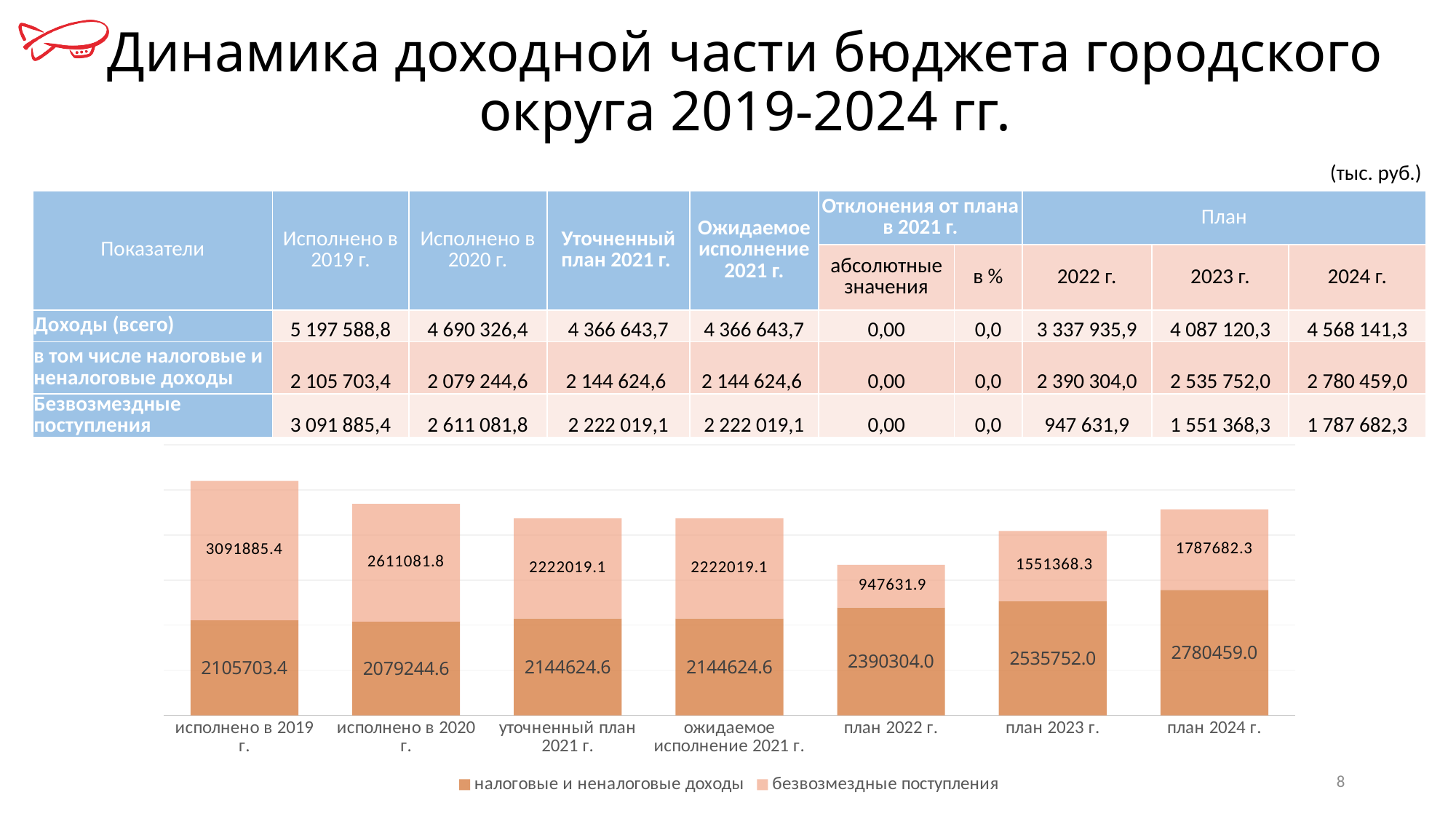
What is the value of безвозмездные поступления for исполнено в 2020 г.? 2611081.8 Which category has the lowest value of безвозмездные поступления? план 2022 г. Which category has the highest value of безвозмездные поступления? исполнено в 2019 г. Which category has the highest value of налоговые и неналоговые доходы? план 2024 г. What is the total of the stacked bar for исполнено в 2019 г.? 5197588.8 How many categories are shown on the x axis of the chart? 7 What is the value of безвозмездные поступления for план 2022 г.? 947631.9 What kind of chart is shown on the slide? stacked bar chart What is the difference between налоговые и неналоговые доходы for план 2024 г. and план 2023 г.? 244707.0 How many series does the chart legend list? 2 Do the values of налоговые и неналоговые доходы rise or fall from план 2022 г. to план 2024 г.? rise What is the value of налоговые и неналоговые доходы for план 2024 г.? 2780459.0